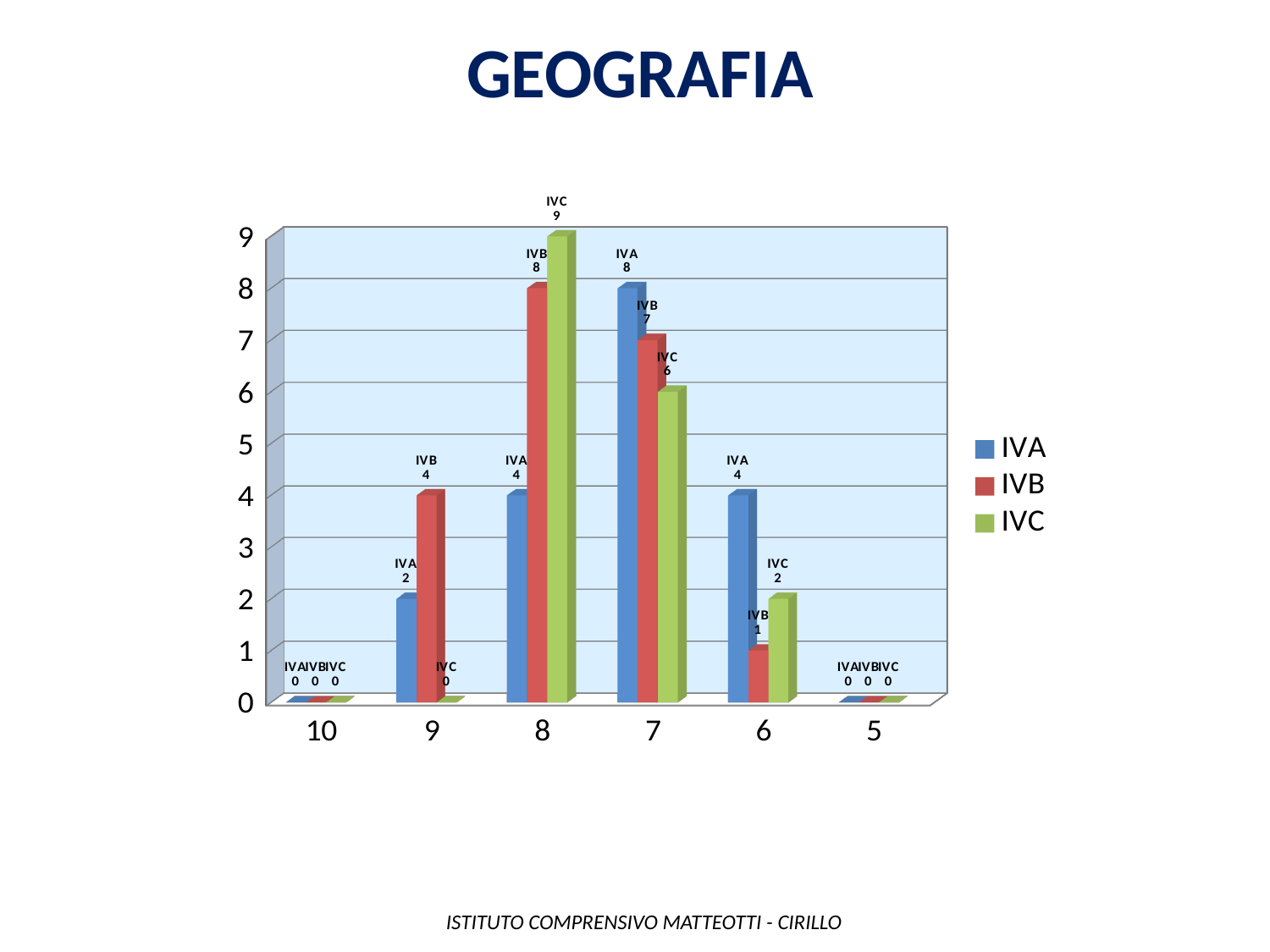
What is the difference between IVB and IVA at category 8? 4 How many categories are shown on the x axis? 6 Which is larger at category 6, IVA or IVC? IVA What is the value for IVB at category 6? 1 What is the title of the slide? GEOGRAFIA Which category has the highest value for the IVC series? 8 What is the value for IVB at category 7? 7 What is the value for IVA at category 9? 2 How many series does the legend list? 3 Which category has the highest value for the IVA series? 7 What kind of chart is shown on the slide? bar chart What is the value for IVC at category 8? 9